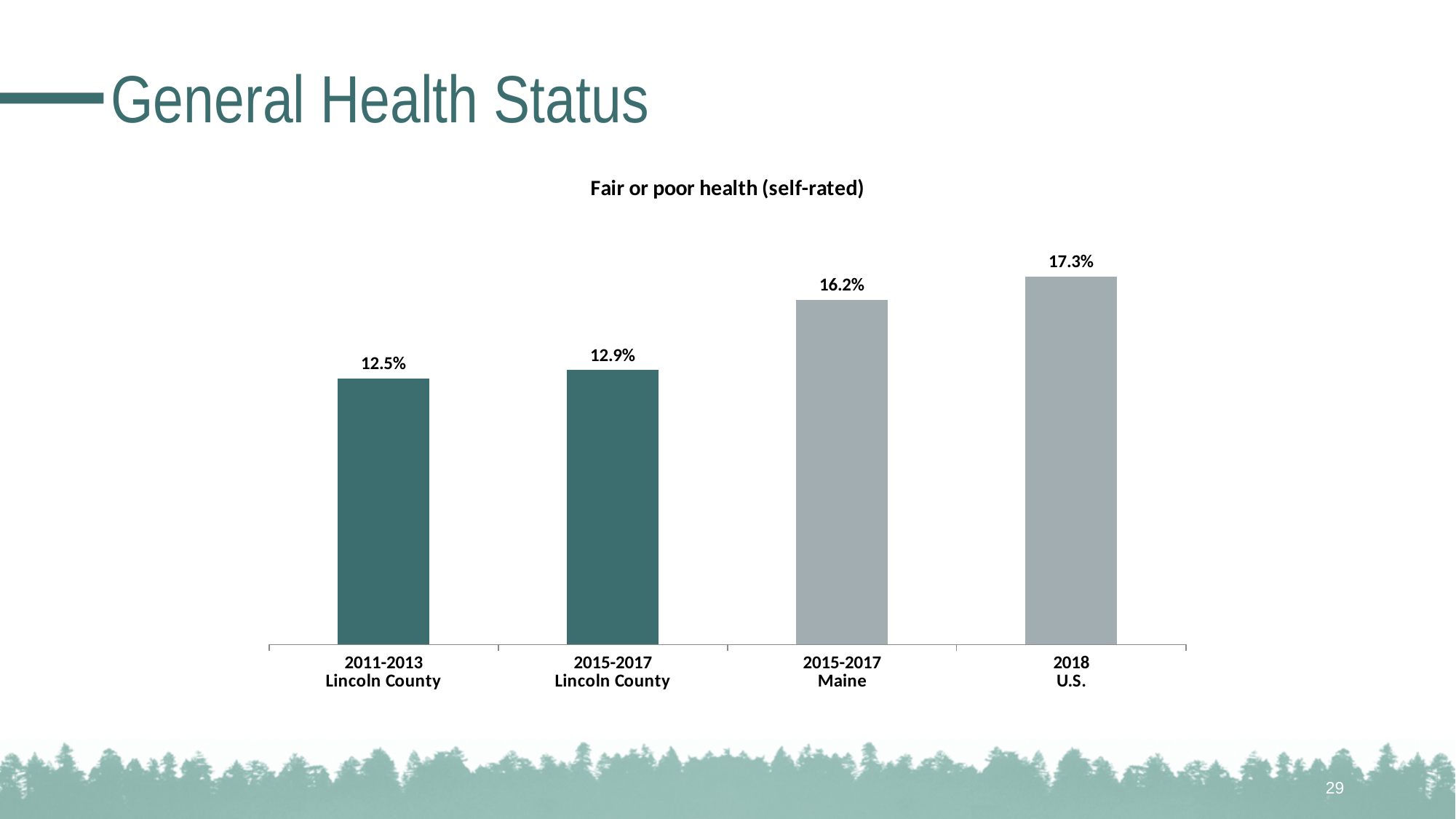
What is the value for 2011-2013 Lincoln County? 12.5% What is the value for 2015-2017 Lincoln County? 12.9% What is the value for 2015-2017 Maine? 16.2% What is the difference between the 2018 U.S. value and the 2015-2017 Maine value? 1.1% Which category has the highest value? 2018 U.S. How many bars are shown in the chart? 4 Which category has the lowest value? 2011-2013 Lincoln County What is the difference between the 2015-2017 Lincoln County value and the 2011-2013 Lincoln County value? 0.4% What kind of chart is shown on the slide? Bar chart Which is larger, the value for 2015-2017 Maine or the value for 2015-2017 Lincoln County? 2015-2017 Maine What is the title of the chart? Fair or poor health (self-rated) What is the value for 2018 U.S.? 17.3%